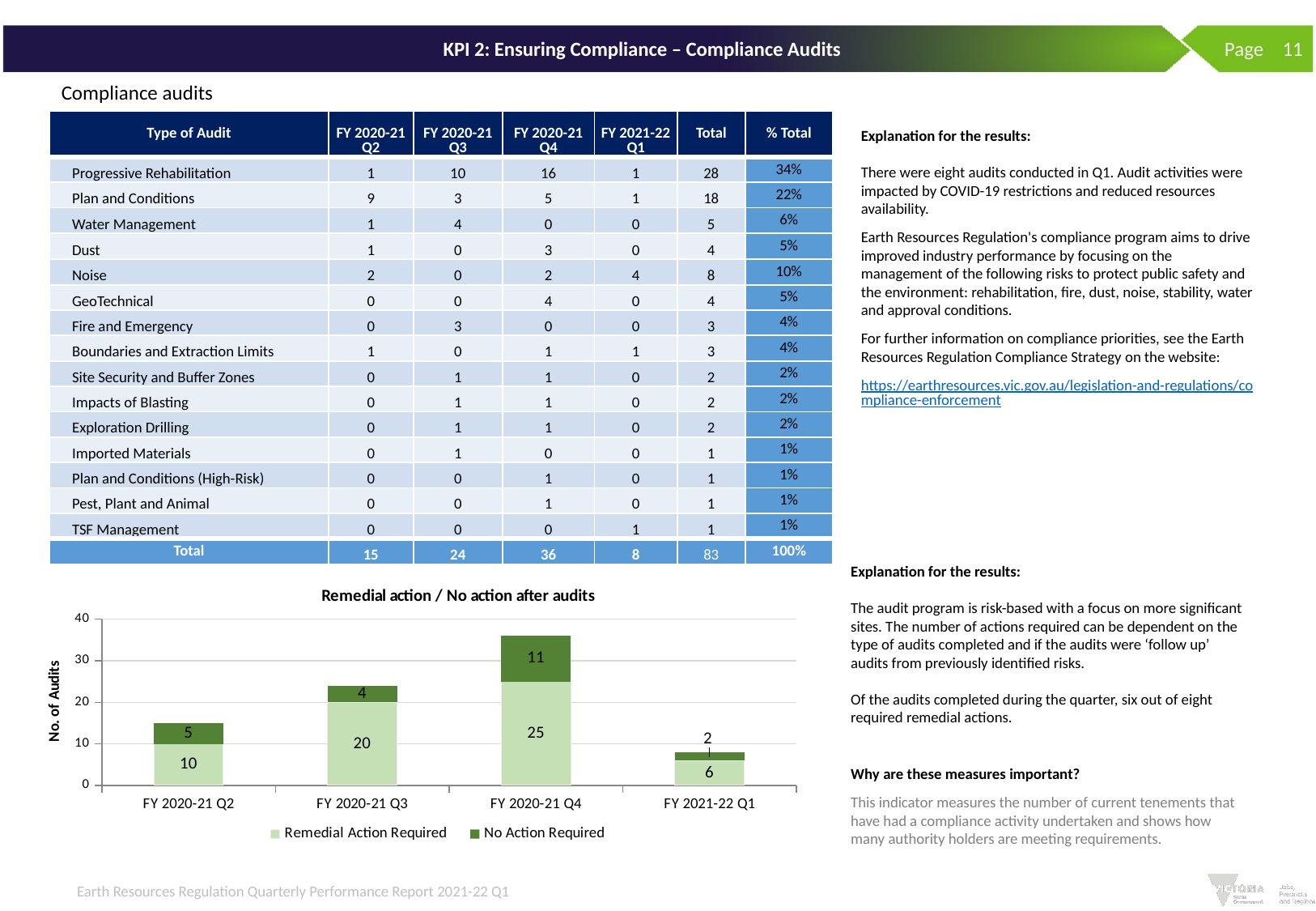
What type of chart is shown under the title "Remedial action / No action after audits"? stacked bar chart How many series does the legend of the "Remedial action / No action after audits" chart list? 2 In the "Remedial action / No action after audits" chart, what is the total number of audits for FY 2020-21 Q4 (both series combined)? 36 In the "Remedial action / No action after audits" chart, which is larger: the No Action Required value for FY 2020-21 Q4 or for FY 2020-21 Q2? FY 2020-21 Q4 In the "Remedial action / No action after audits" chart, how many audits required no action in FY 2020-21 Q3? 4 In the "Remedial action / No action after audits" chart, what is the Remedial Action Required value for FY 2021-22 Q1? 6 In the "Remedial action / No action after audits" chart, what is the total number of audits for FY 2020-21 Q2 (both series combined)? 15 In the "Remedial action / No action after audits" chart, what is the difference between the Remedial Action Required values for FY 2020-21 Q3 and FY 2020-21 Q2? 10 In the "Remedial action / No action after audits" chart, which quarter has the highest number of audits requiring remedial action? FY 2020-21 Q4 In the "Remedial action / No action after audits" chart, which quarter has the lowest number of audits requiring no action? FY 2021-22 Q1 In the "Remedial action / No action after audits" chart, how many audits required remedial action in FY 2020-21 Q4? 25 How many quarters are shown on the x axis of the "Remedial action / No action after audits" chart? 4